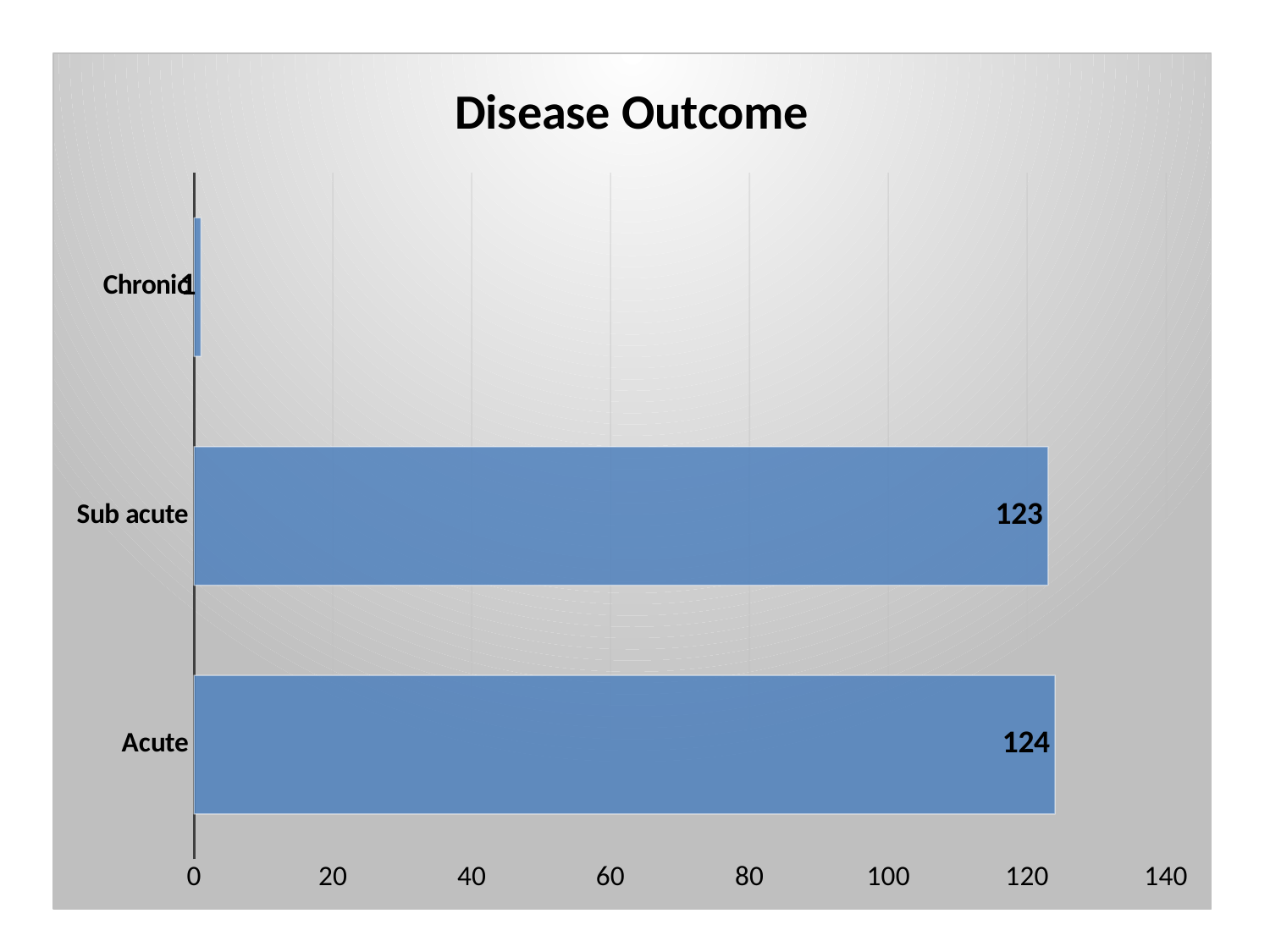
What is the value for Sub acute? 123 Which category has the lowest value? Chronic Which category has the highest value? Acute Which is larger, the value for Sub acute or the value for Chronic? Sub acute What is the difference between the values for Acute and Sub acute? 1 What kind of chart is shown on the slide? Bar chart What is the value for Acute? 124 How many categories are shown in the chart? 3 What is the difference between the values for Sub acute and Chronic? 122 Is the value for Acute greater or less than 100? greater What is the value for Chronic? 1 What is the title of the chart? Disease Outcome